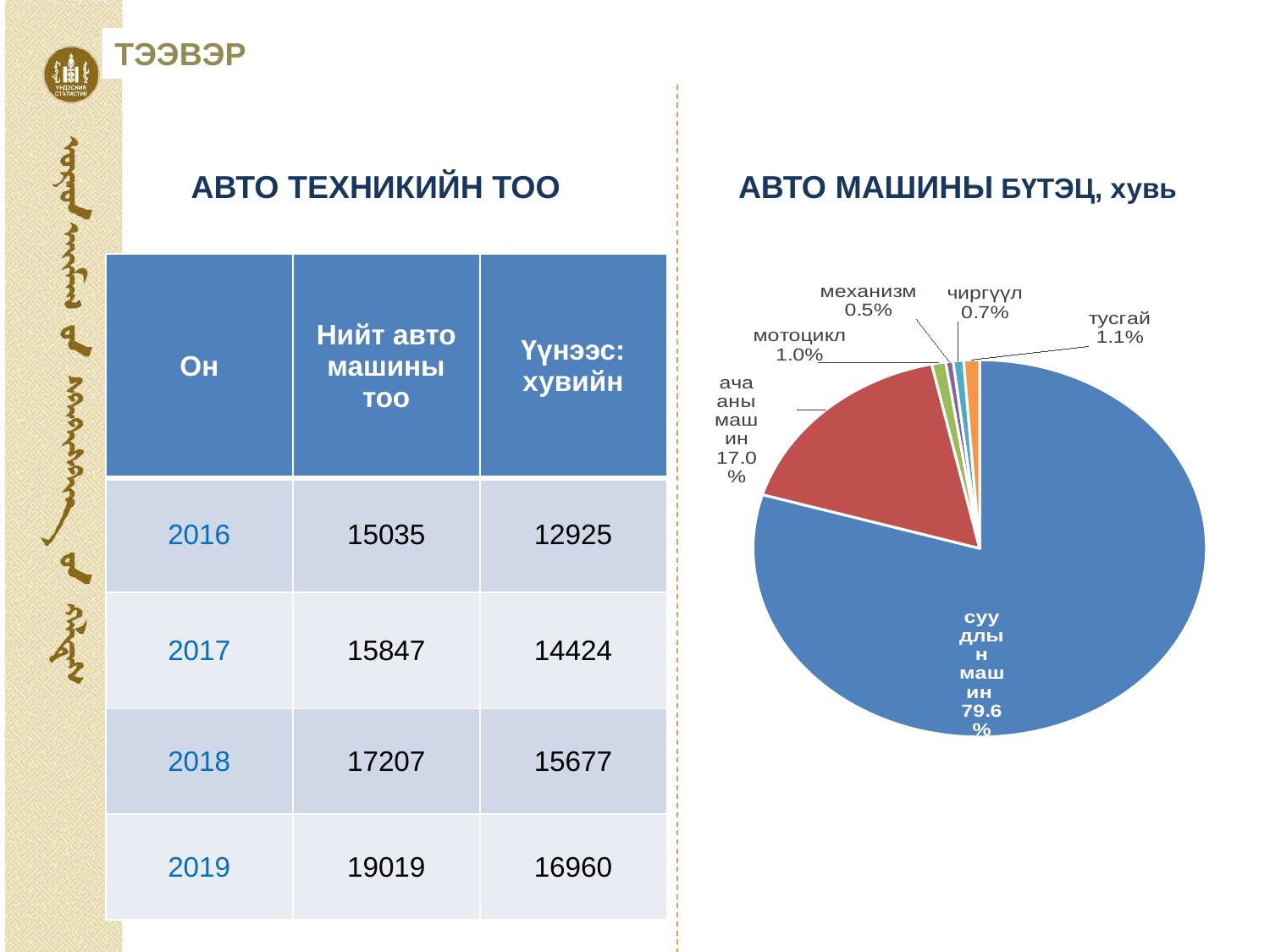
In the pie chart 'АВТО МАШИНЫ БҮТЭЦ, хувь', what share does 'суудлын машин' have? 79.6% In the pie chart 'АВТО МАШИНЫ БҮТЭЦ, хувь', which is larger: 'ачааны машин' or 'тусгай'? ачааны машин In the pie chart 'АВТО МАШИНЫ БҮТЭЦ, хувь', which category has the largest slice? суудлын машин In the pie chart 'АВТО МАШИНЫ БҮТЭЦ, хувь', how many slices (categories) are shown? 6 In the pie chart 'АВТО МАШИНЫ БҮТЭЦ, хувь', which category has the smallest slice? механизм In the pie chart 'АВТО МАШИНЫ БҮТЭЦ, хувь', what is the difference in percentage points between 'суудлын машин' and 'ачааны машин'? 62.6 In the pie chart 'АВТО МАШИНЫ БҮТЭЦ, хувь', what is the value for 'механизм'? 0.5% In the pie chart 'АВТО МАШИНЫ БҮТЭЦ, хувь', what is the value for 'ачааны машин'? 17.0% In the pie chart 'АВТО МАШИНЫ БҮТЭЦ, хувь', what is the value for 'чиргүүл'? 0.7% In the pie chart 'АВТО МАШИНЫ БҮТЭЦ, хувь', what is the value for 'мотоцикл'? 1.0% What kind of chart is shown on the right side of the slide under the title 'АВТО МАШИНЫ БҮТЭЦ, хувь'? pie chart In the pie chart 'АВТО МАШИНЫ БҮТЭЦ, хувь', what is the value for 'тусгай'? 1.1%